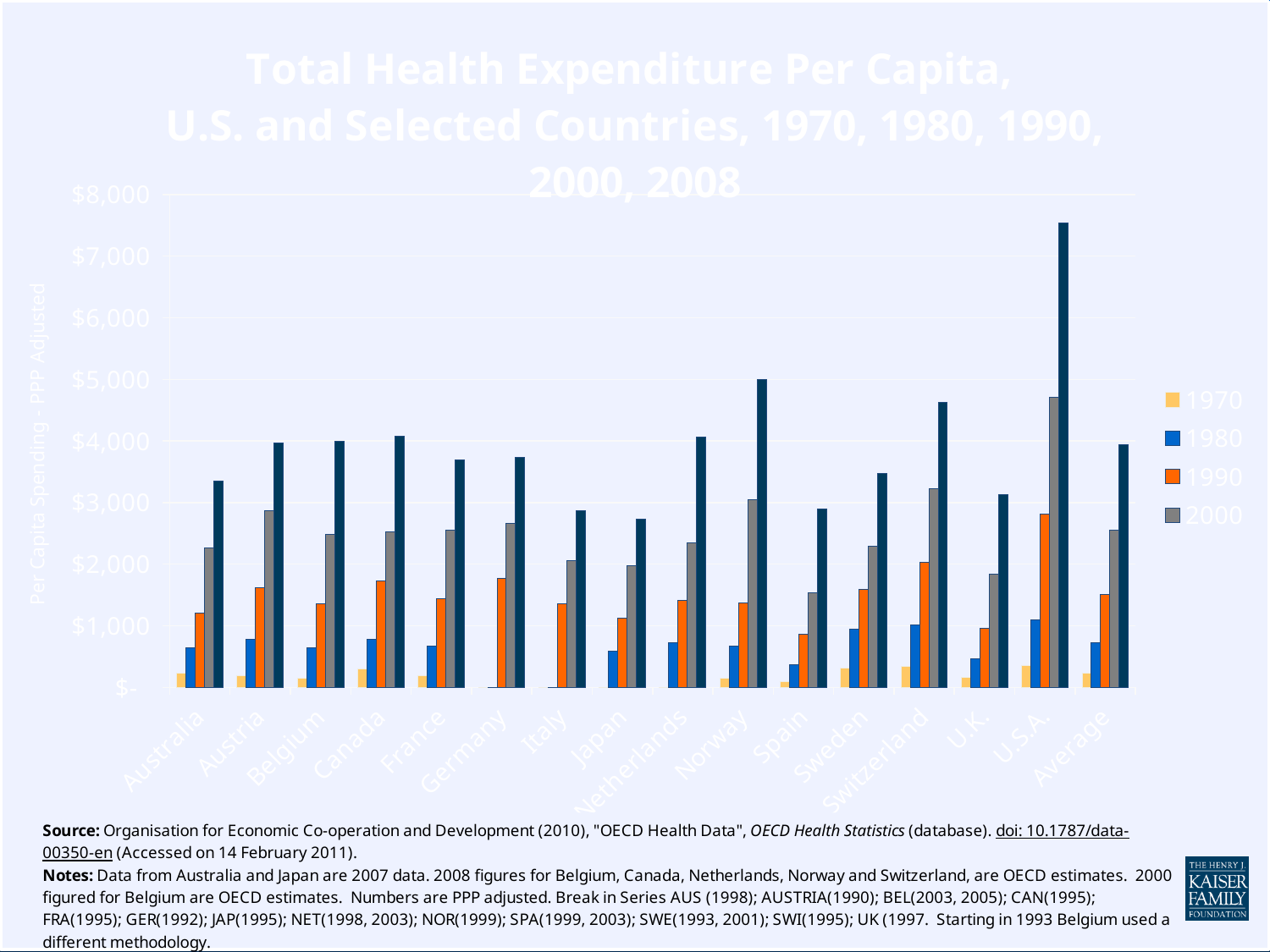
Which country has the highest 2000 (grey bar) health expenditure per capita? U.S.A. How many countries/categories are shown along the x axis? 16 For the U.S.A., do the bars rise or fall from 1970 through 2008? rise Which is larger, the 2008 value for Norway or the 2008 value for Switzerland? Norway Is the 2008 value for Japan greater or less than $3,000? less What colour represents the 1990 series in the legend? orange Is the 1990 value for the U.S.A. greater or less than $2,000? greater What kind of chart is shown on the slide? bar chart Which country has the highest 2008 (tallest dark bar) health expenditure per capita? U.S.A. Is the 2000 value for the U.K. greater or less than $2,000? less How many series does the legend list? 4